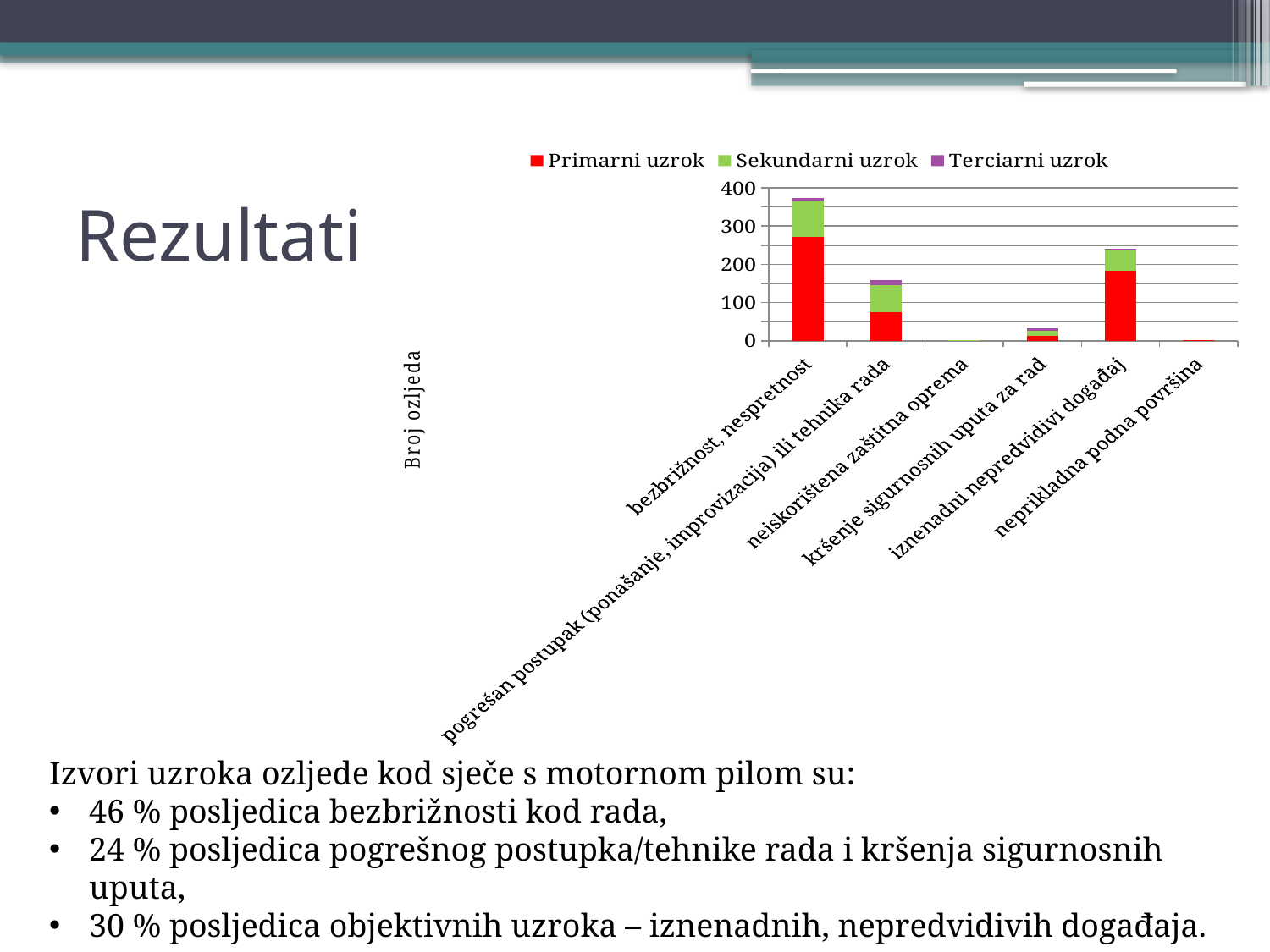
Which has a larger total: pogrešan postupak (ponašanje, improvizacija) ili tehnika rada or kršenje sigurnosnih uputa za rad? pogrešan postupak (ponašanje, improvizacija) ili tehnika rada Which category has the highest total number of injuries? bezbrižnost, nespretnost What kind of chart is shown on the slide? stacked bar chart Which has a larger total: bezbrižnost, nespretnost or iznenadni nepredvidivi događaj? bezbrižnost, nespretnost Is the total value for iznenadni nepredvidivi događaj greater or less than 200? greater How many series does the legend list? 3 Is the total value for bezbrižnost, nespretnost greater or less than 300? greater Is the Primarni uzrok value for bezbrižnost, nespretnost greater or less than 200? greater What is the label of the y axis? Broj ozljeda How many categories are shown on the x axis? 6